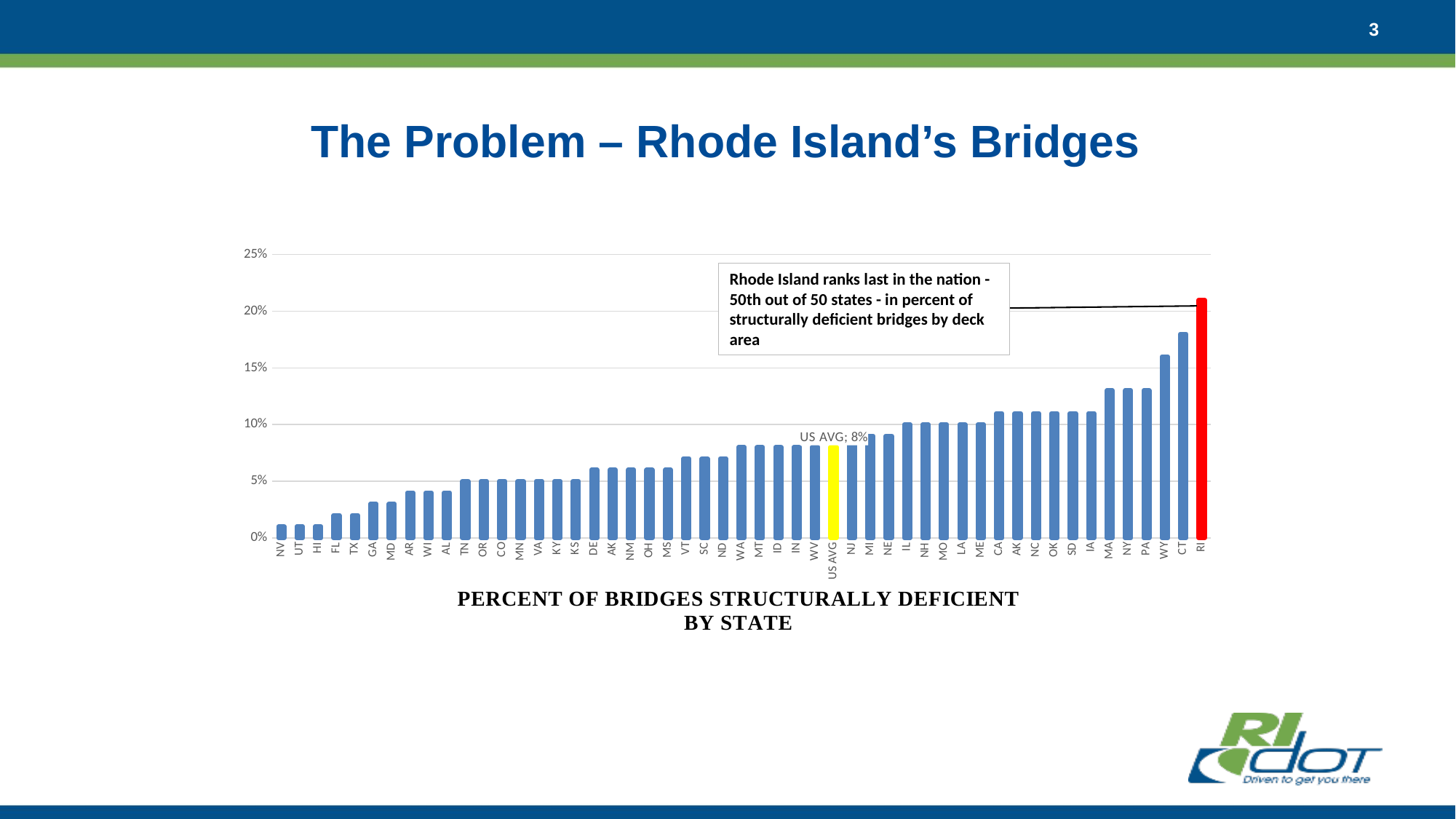
What colour is the bar for RI? red Is the value for CT greater or less than 20%? less What value is labelled for US AVG? 8% What kind of chart is shown on the slide? bar chart Is the value for RI greater or less than 20%? greater Which is larger, the value for RI or the value for CT? RI What is the title of the chart? PERCENT OF BRIDGES STRUCTURALLY DEFICIENT BY STATE Is the value for WY greater or less than 15%? greater Do the values rise or fall moving from left to right along the x axis? rise Which state has the highest percent of structurally deficient bridges? RI